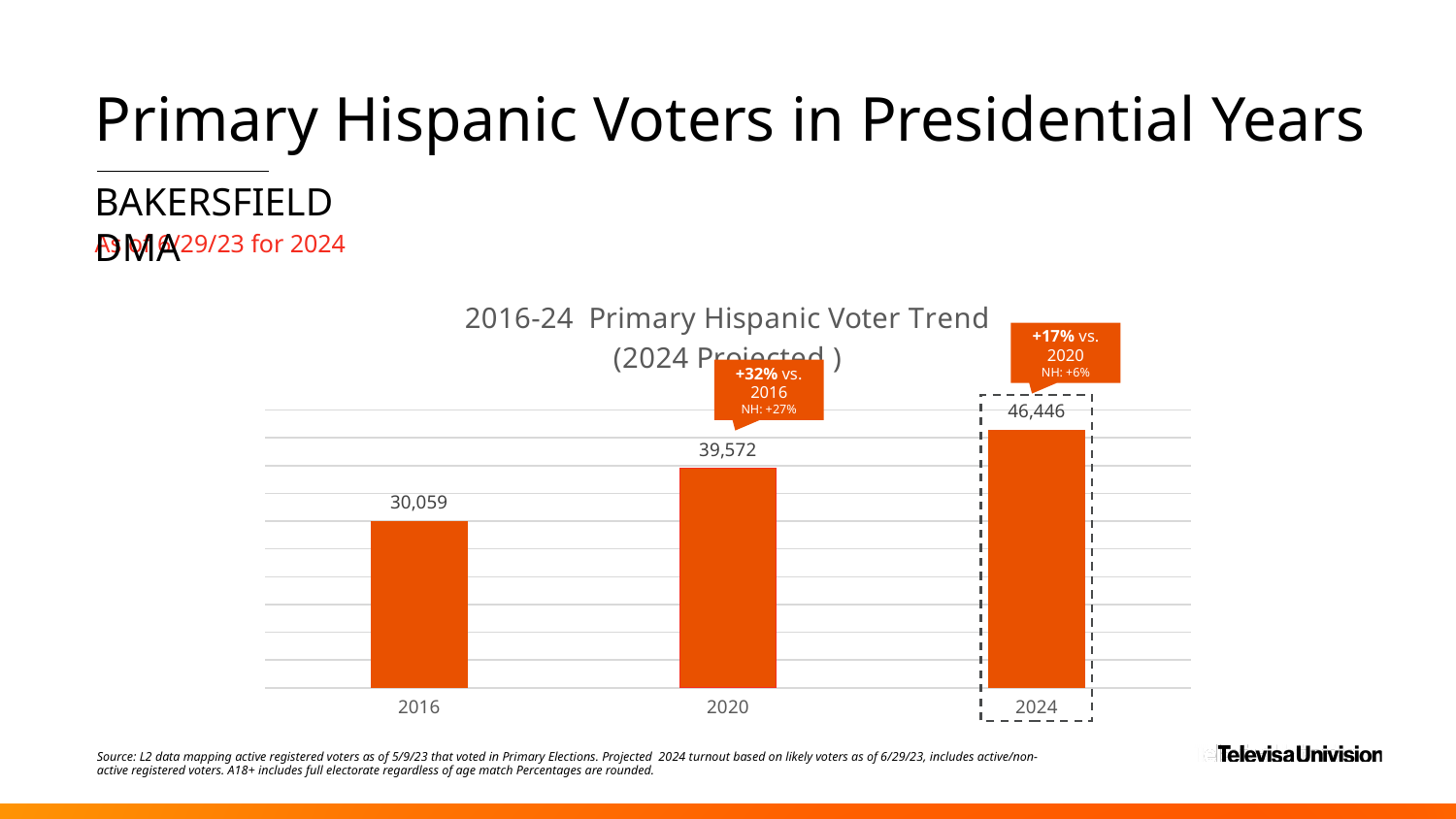
What is the difference between the 2024 and 2020 values? 6,874 What is the value for 2020? 39,572 Which year has the lowest value? 2016 Which is larger, the value for 2016 or the value for 2020? 2020 What is the projected value for 2024? 46,446 What is the value for 2016? 30,059 How many years are shown on the x axis? 3 Which year has the highest value? 2024 What kind of chart is this? bar chart Do the values rise or fall from 2016 to 2024? rise What percentage change versus 2016 is shown in the callout above the 2020 bar? +32% What is the difference between the 2020 and 2016 values? 9,513